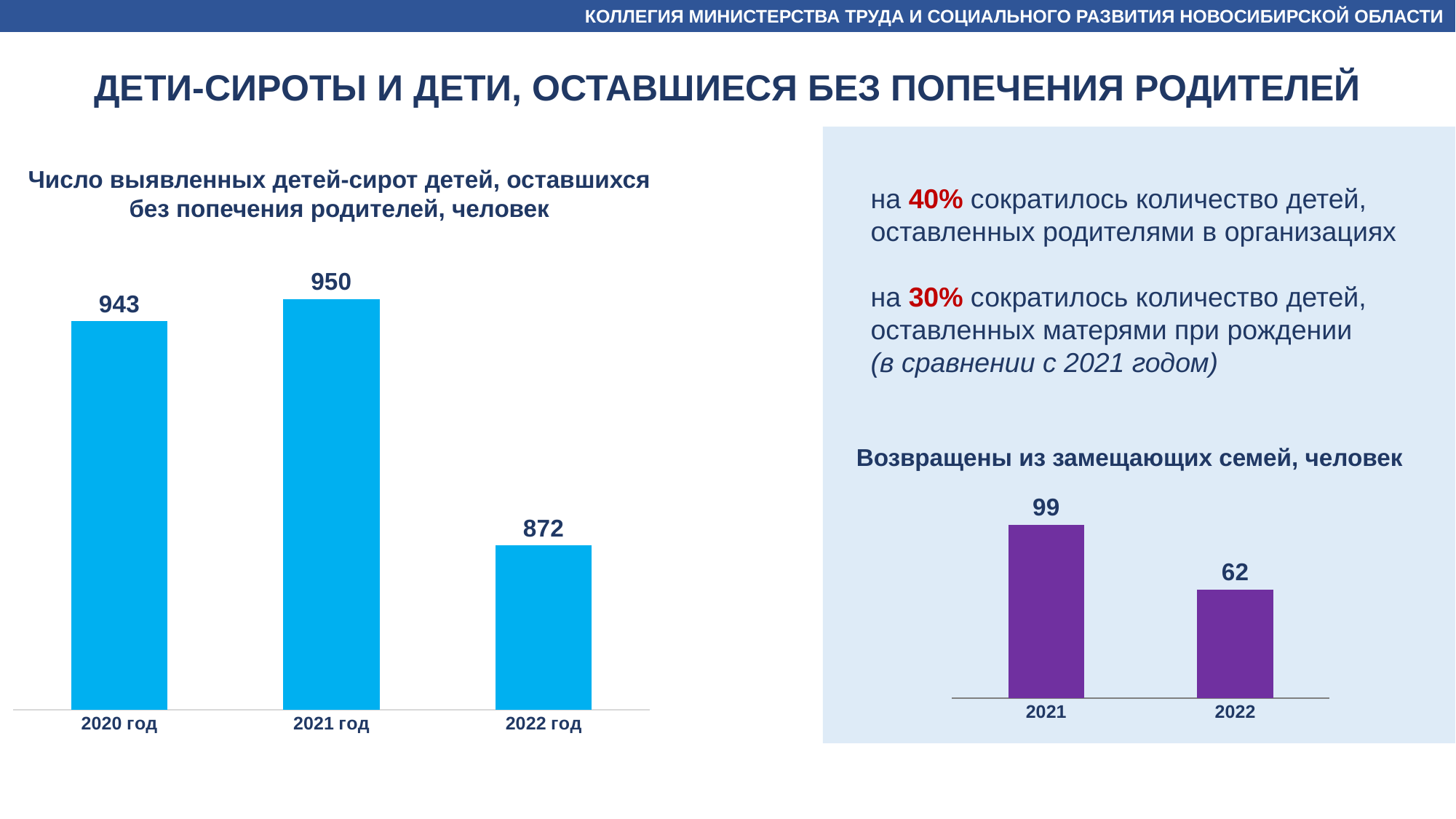
What type of chart is the left chart 'Число выявленных детей-сирот детей, оставшихся без попечения родителей, человек'? bar chart In the right chart 'Возвращены из замещающих семей, человек', what is the difference between the values for 2021 and 2022? 37 In the left chart 'Число выявленных детей-сирот детей, оставшихся без попечения родителей, человек', what is the value for 2021 год? 950 In the right chart 'Возвращены из замещающих семей, человек', what is the value for 2021? 99 In the right chart 'Возвращены из замещающих семей, человек', what is the value for 2022? 62 In the left chart 'Число выявленных детей-сирот детей, оставшихся без попечения родителей, человек', what is the value for 2022 год? 872 In the left chart 'Число выявленных детей-сирот детей, оставшихся без попечения родителей, человек', what is the difference between the values for 2021 год and 2022 год? 78 In the left chart 'Число выявленных детей-сирот детей, оставшихся без попечения родителей, человек', which year has the highest value? 2021 год In the left chart 'Число выявленных детей-сирот детей, оставшихся без попечения родителей, человек', how many years are shown? 3 In the right chart 'Возвращены из замещающих семей, человек', do the values rise or fall from 2021 to 2022? fall In the left chart 'Число выявленных детей-сирот детей, оставшихся без попечения родителей, человек', which year has the lowest value? 2022 год In the left chart 'Число выявленных детей-сирот детей, оставшихся без попечения родителей, человек', which is larger: the value for 2020 год or 2022 год? 2020 год